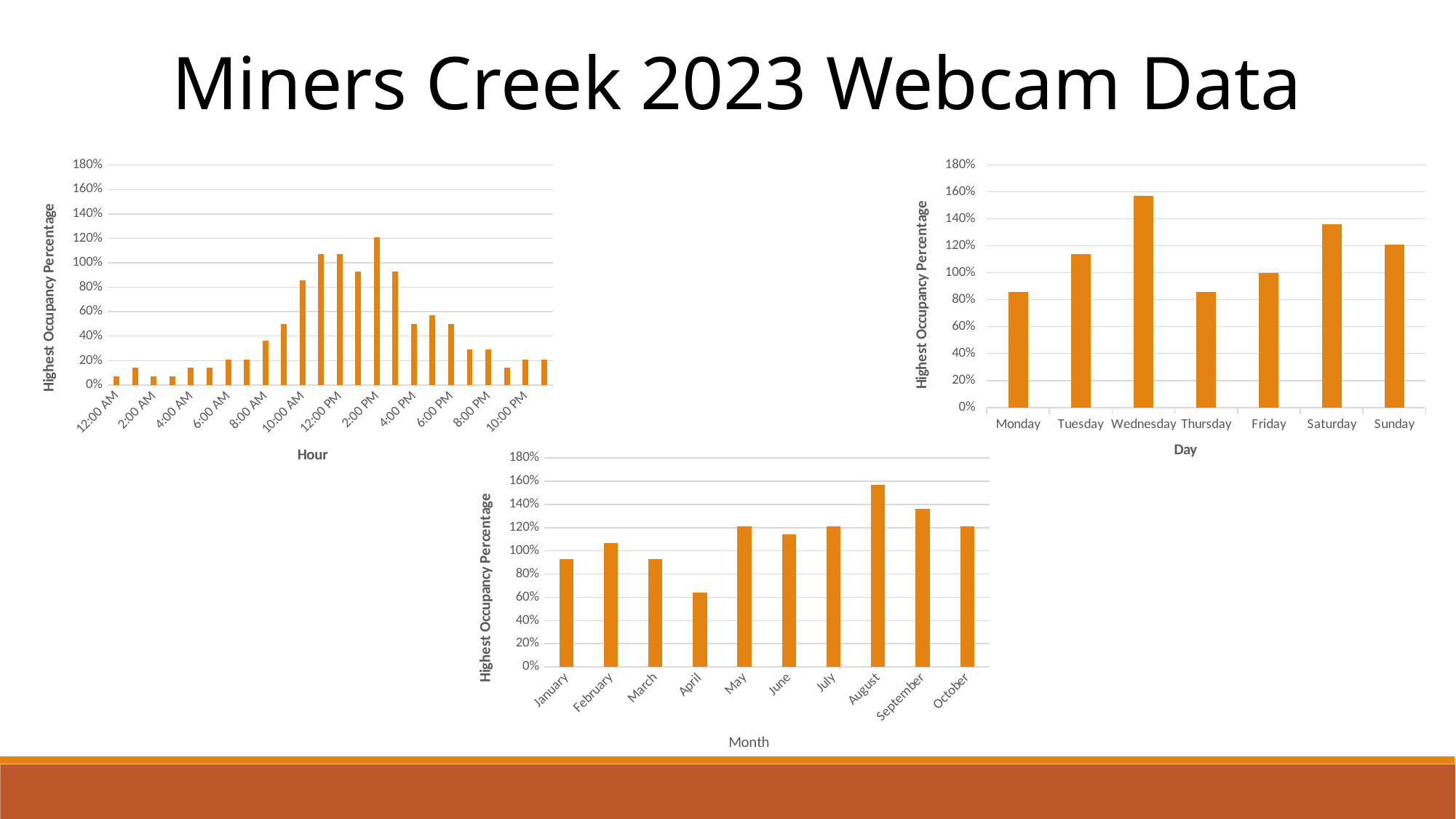
In the chart with the x axis labelled Day, which day has the highest occupancy percentage? Wednesday In the chart with the x axis labelled Hour, which hour has the highest occupancy percentage? 2:00 PM In the chart with the x axis labelled Month, which month has the lowest occupancy percentage? April How many months are shown in the chart with the x axis labelled Month? 10 In the chart with the x axis labelled Month, is the value for April greater or less than 80%? less In the chart with the x axis labelled Month, which month has the highest occupancy percentage? August What kind of chart is the chart with the x axis labelled Month? Bar chart In the chart with the x axis labelled Day, is the value for Monday greater or less than 100%? less In the chart with the x axis labelled Month, which is larger, the value for September or the value for June? September In the chart with the x axis labelled Day, is the value for Wednesday greater or less than 140%? greater How many days are shown in the chart with the x axis labelled Day? 7 In the chart with the x axis labelled Day, which is larger, the value for Saturday or the value for Sunday? Saturday